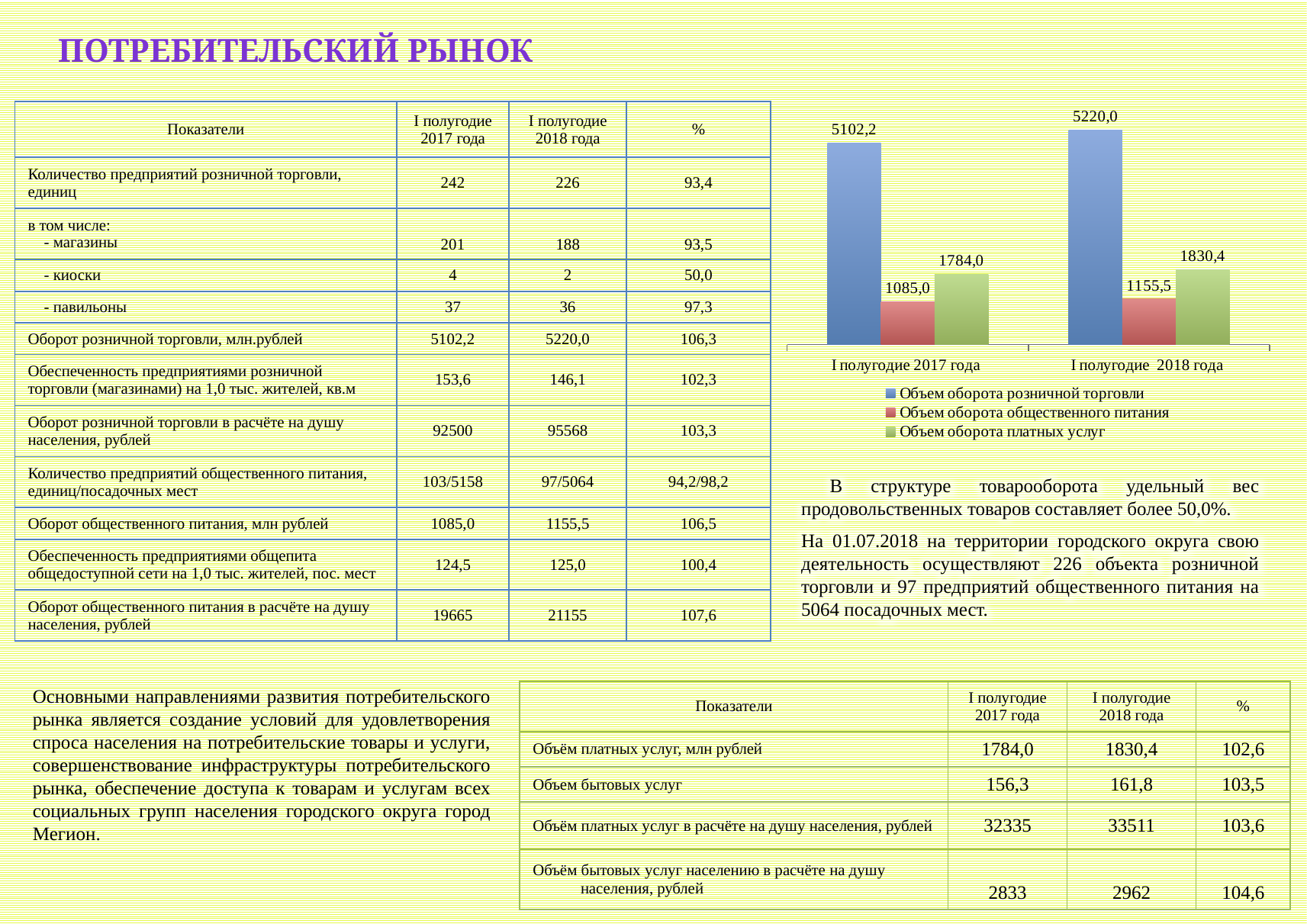
What is the value of Объем оборота платных услуг for I полугодие 2017 года? 1784,0 Which series has the lowest value in I полугодие 2017 года? Объем оборота общественного питания How many categories are shown on the x axis of the chart? 2 Which is larger: Объем оборота платных услуг in I полугодие 2017 года or in I полугодие 2018 года? I полугодие 2018 года How many series does the chart legend list? 3 Which series has the highest value in I полугодие 2018 года? Объем оборота розничной торговли What type of chart is shown on the slide? bar chart Does Объем оборота общественного питания rise or fall from I полугодие 2017 года to I полугодие 2018 года? rise What is the value of Объем оборота общественного питания for I полугодие 2018 года? 1155,5 What is the value of Объем оборота розничной торговли for I полугодие 2017 года? 5102,2 What colour are the bars for Объем оборота платных услуг in the chart? green What is the difference between Объем оборота розничной торговли in I полугодие 2018 года and I полугодие 2017 года? 117,8